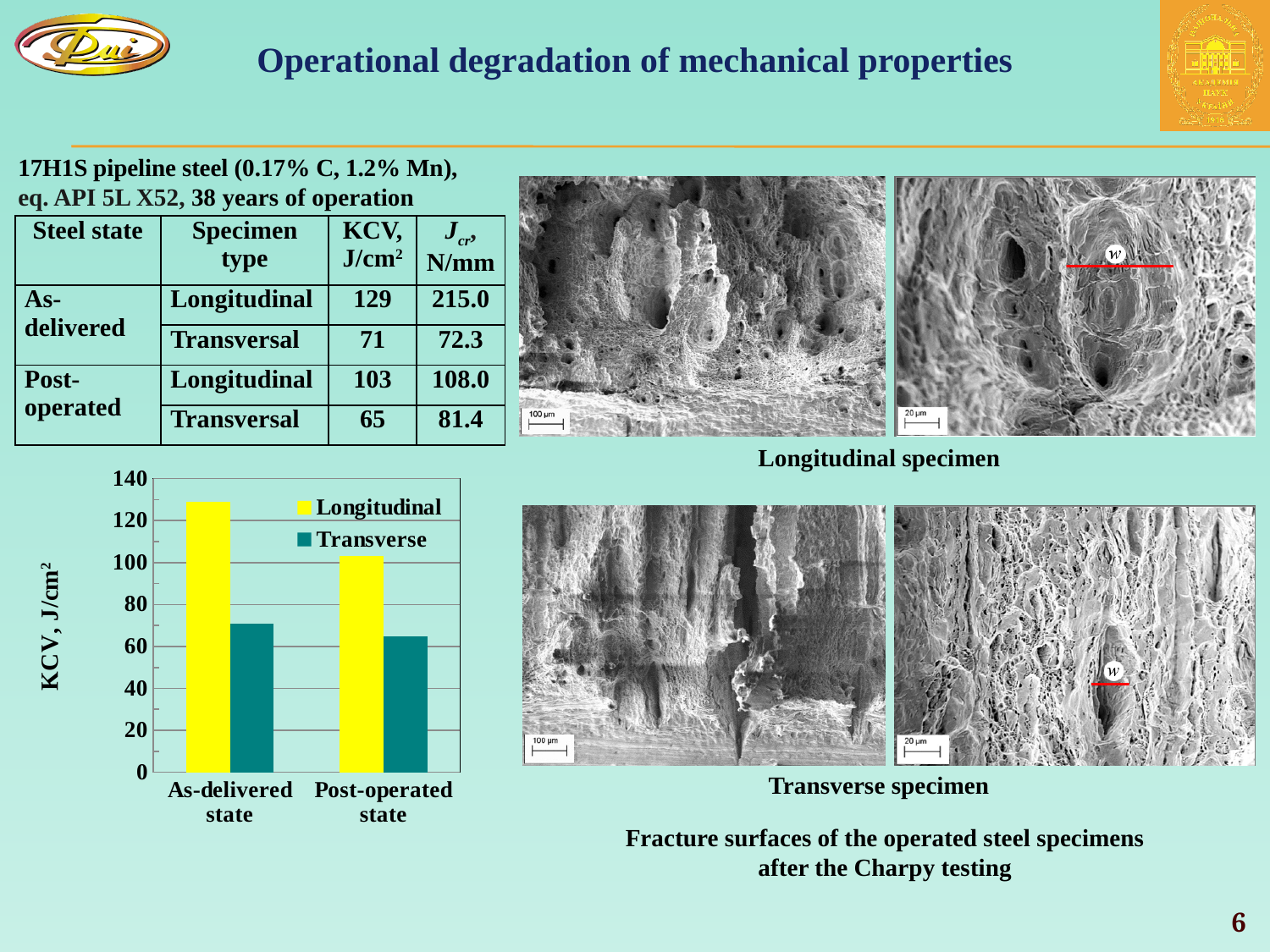
Is the Longitudinal value in the Post-operated state greater or less than 100? greater What is the difference between the Longitudinal and Transverse KCV values in the As-delivered state? 58 Which bar in the chart is the highest? Longitudinal, As-delivered state What is the KCV value for the Transverse series in the Post-operated state? 65 Is the Transverse value in the As-delivered state greater or less than 80? less What kind of chart is shown on the slide? bar chart What is the KCV value for the Longitudinal series in the As-delivered state? 129 Which bar in the chart is the lowest? Transverse, Post-operated state Which is larger: the Longitudinal value in the As-delivered state or the Longitudinal value in the Post-operated state? As-delivered state How many categories are shown on the x axis of the chart? 2 How many series does the chart legend list? 2 What is the label of the y axis of the chart? KCV, J/cm²